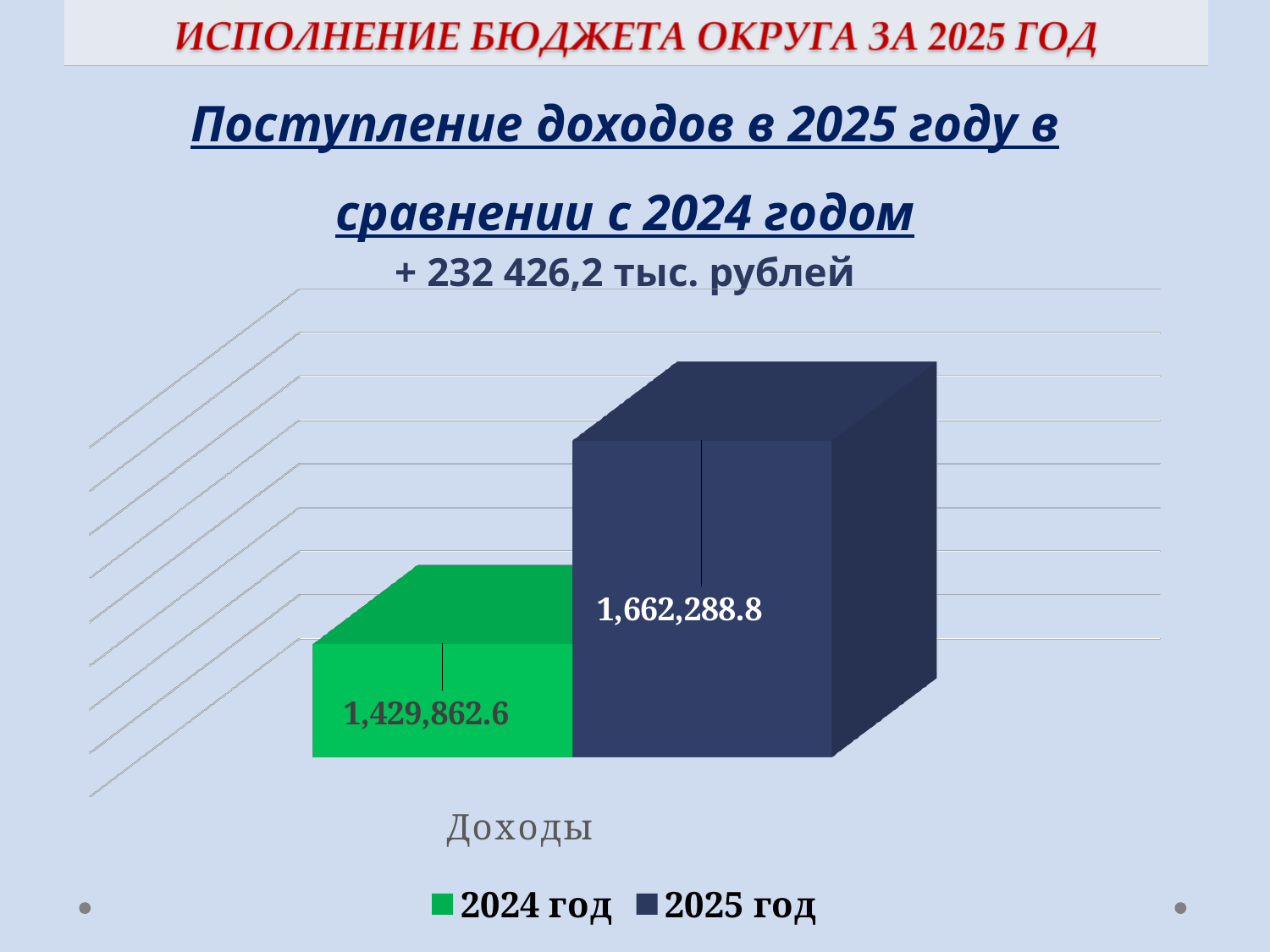
What is the value for 2024 год in the Доходы chart? 1,429,862.6 Which series shows the highest value in the chart? 2025 год What kind of chart is shown on the slide? Bar chart What is the value for 2025 год in the Доходы chart? 1,662,288.8 What is the difference between the 2025 год and 2024 год values for Доходы? 232,426.2 Which series has the higher value for Доходы, 2024 год or 2025 год? 2025 год How many series does the legend list? 2 Which series shows the lowest value in the chart? 2024 год Which colour represents the 2024 год series in the chart? Green What is the label of the category on the x axis? Доходы How many categories are shown on the x axis of the chart? 1